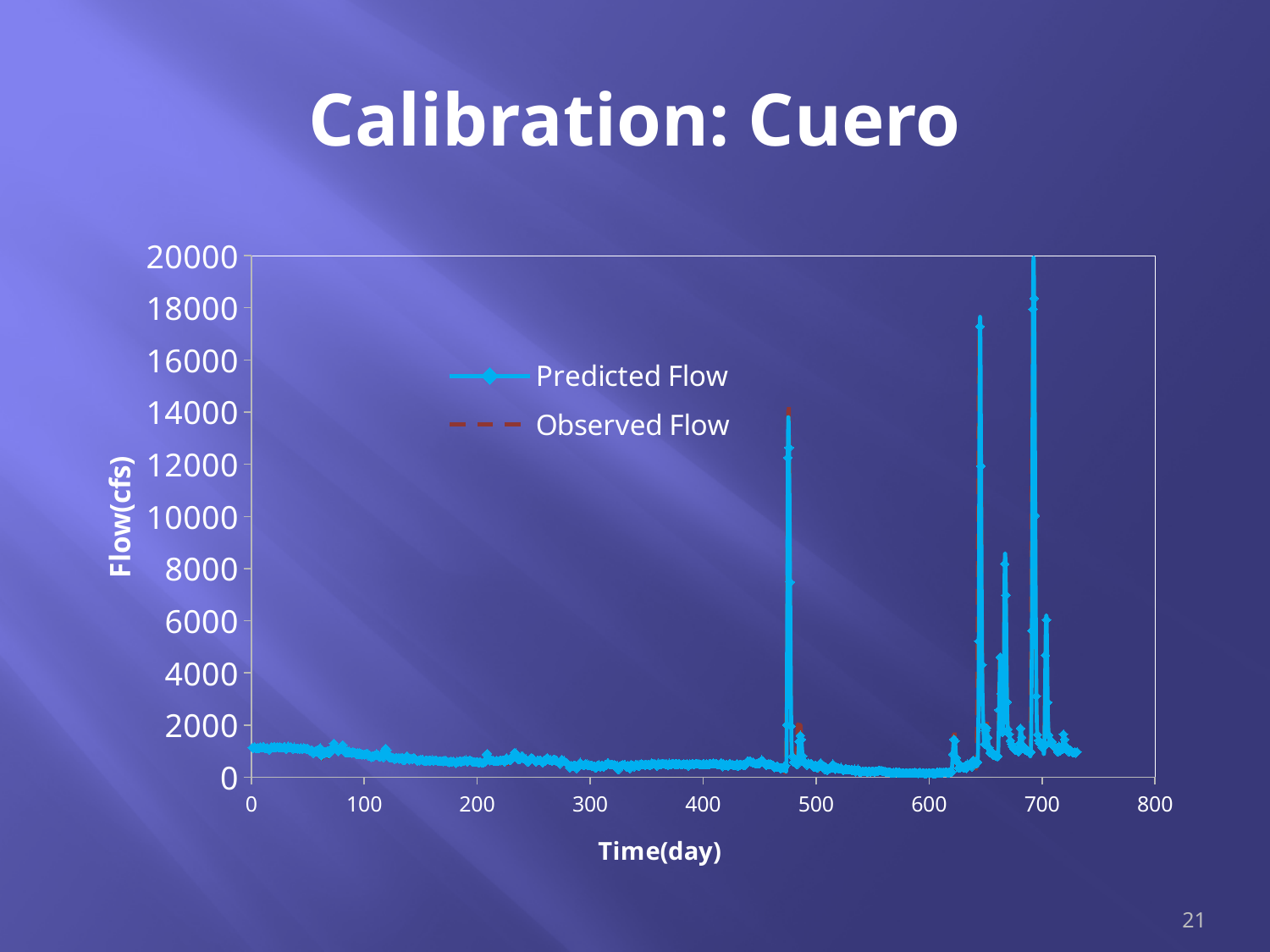
Which peak is higher: the one near day 475 or the one near day 645? the one near day 645 What is the maximum value shown on the Flow(cfs) axis? 20000 What is the title of the chart's vertical axis? Flow(cfs) What are the two series named in the legend? Predicted Flow and Observed Flow What kind of chart is shown on the slide? line chart How many series does the legend list? 2 Does the flow generally rise or fall between day 0 and day 300? fall Is the peak flow near day 475 greater or less than 12000? greater Is the flow at around day 300 greater or less than 2000? less Is the peak flow near day 665 greater or less than 10000? less